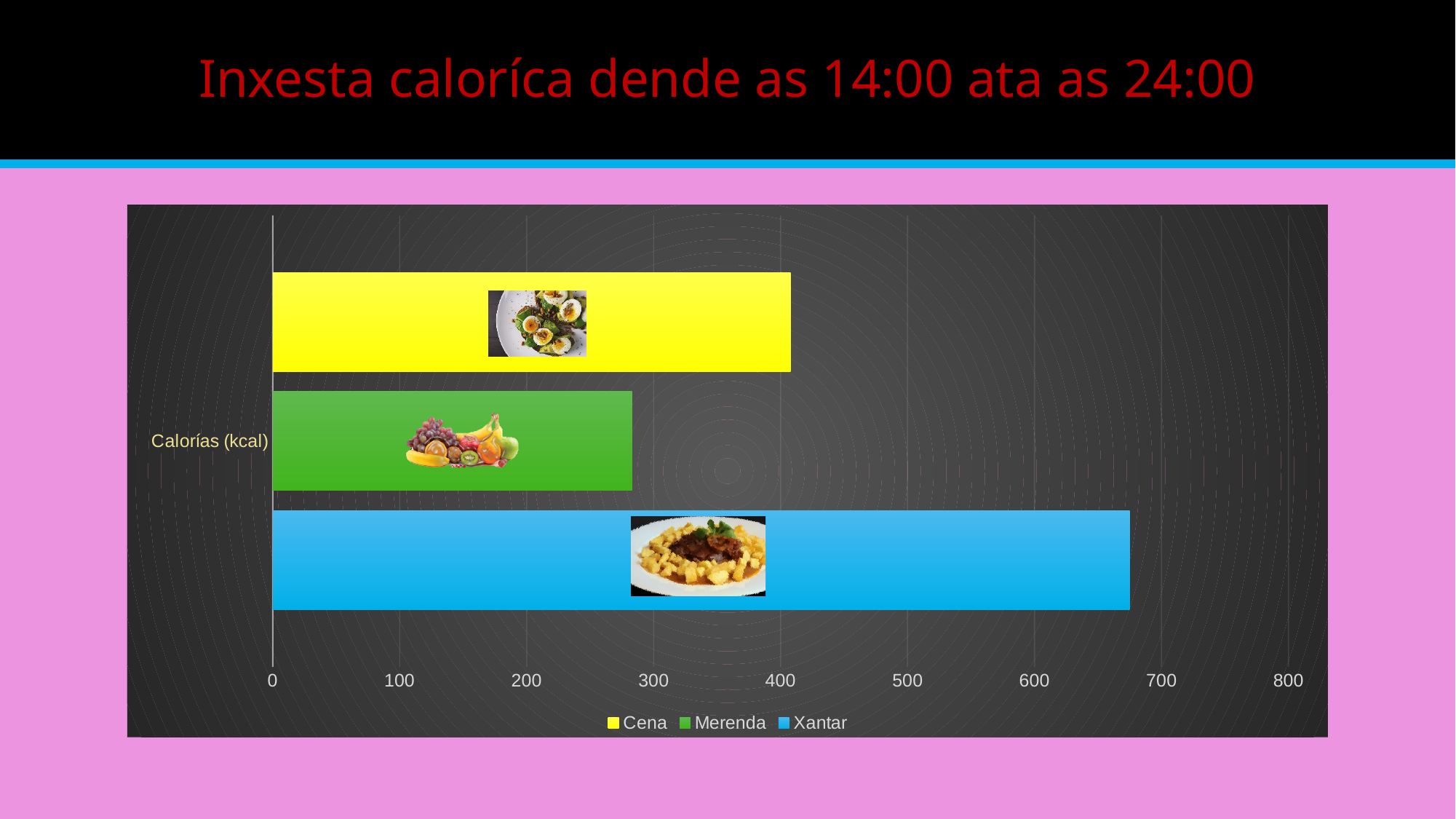
What colour is the bar for Merenda? green Is the value for Merenda greater or less than 300? less How many series does the legend list? 3 What kind of chart is shown on the slide? bar chart Which is larger, the value for Cena or the value for Merenda? Cena What is the title of the slide? Inxesta calorícа dende as 14:00 ata as 24:00 Which series has the highest value? Xantar How many categories are shown on the vertical axis? 1 Which series has the lowest value? Merenda Which is larger, the value for Xantar or the value for Cena? Xantar Is the value for Xantar greater or less than 600? greater